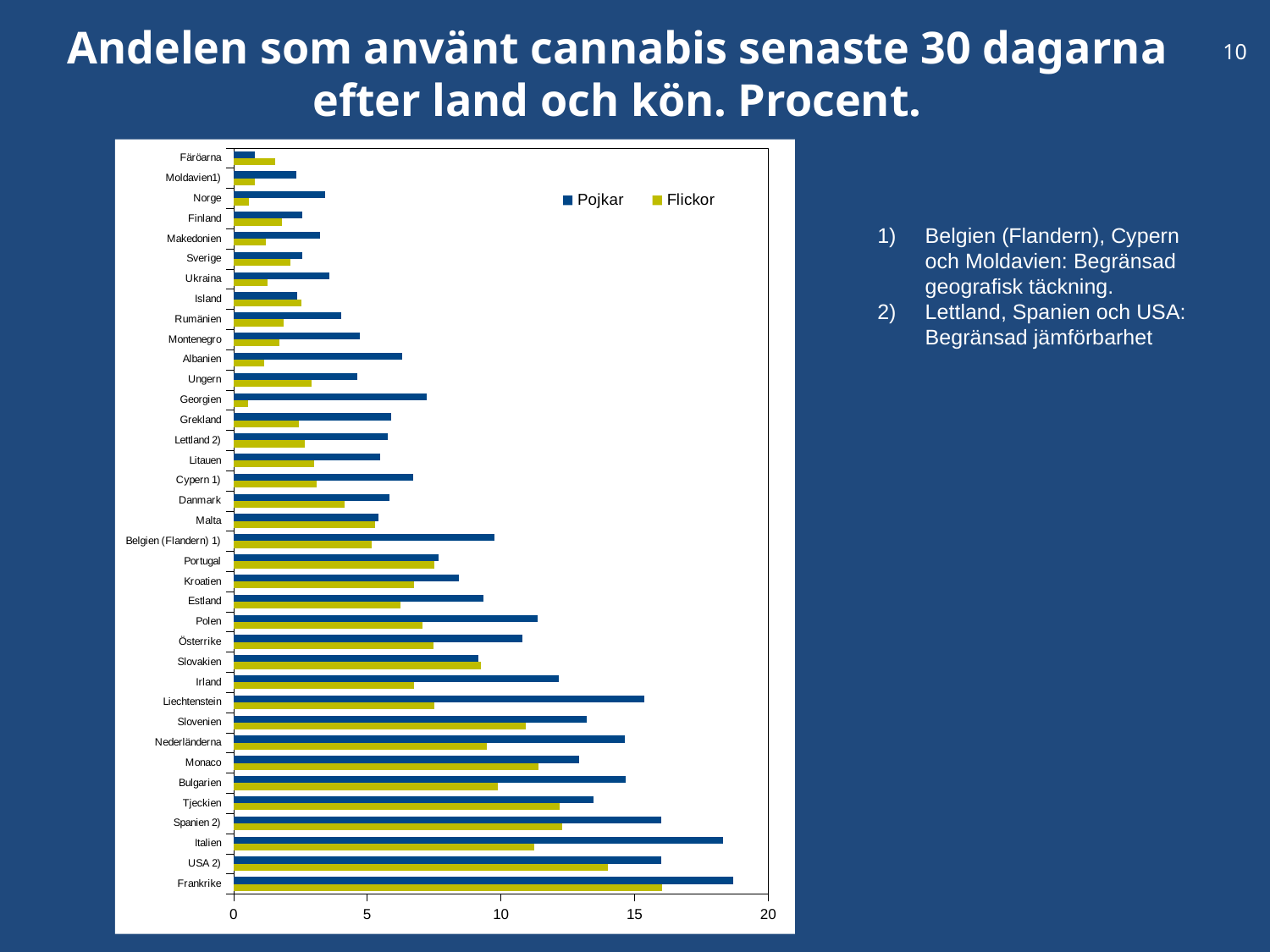
Is the Pojkar value for Färöarna greater or less than 5? less For Norge, which is larger, the Pojkar value or the Flickor value? Pojkar What are the two series named in the legend? Pojkar and Flickor How many series does the legend list? 2 How many countries are shown on the chart? 37 Which is larger, the Flickor value for Frankrike or the Flickor value for Italien? Frankrike Which country has the highest Flickor value? Frankrike Which country has the lowest Pojkar value? Färöarna Is the Flickor value for Frankrike greater or less than 10? greater What kind of chart is shown on the slide? Bar chart Is the Pojkar value for Frankrike greater or less than 15? greater